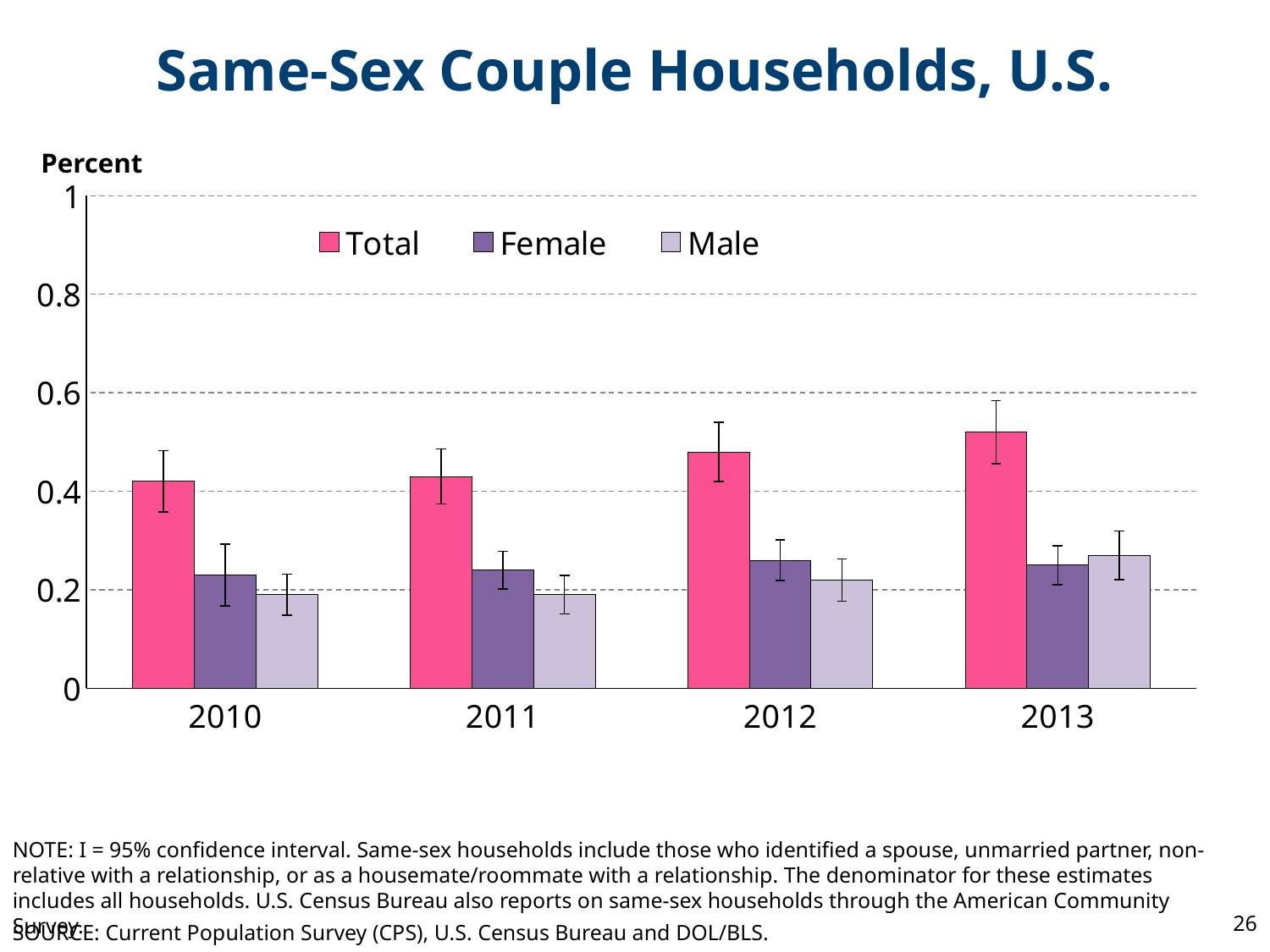
How many series does the legend list? 3 Is the Total value for 2010 greater or less than 0.4? greater Which is larger, the Male value for 2013 or the Male value for 2010? 2013 Which year has the highest Total value? 2013 Is the Total value for 2013 greater or less than 0.6? less Is the Male value for 2013 greater or less than 0.2? greater What label is shown on the vertical axis of the chart? Percent How many years are shown along the x axis? 4 Do the Total values rise or fall from 2010 to 2013? rise What kind of chart is shown on the slide? bar chart In 2012, which is larger, the Total value or the Female value? Total